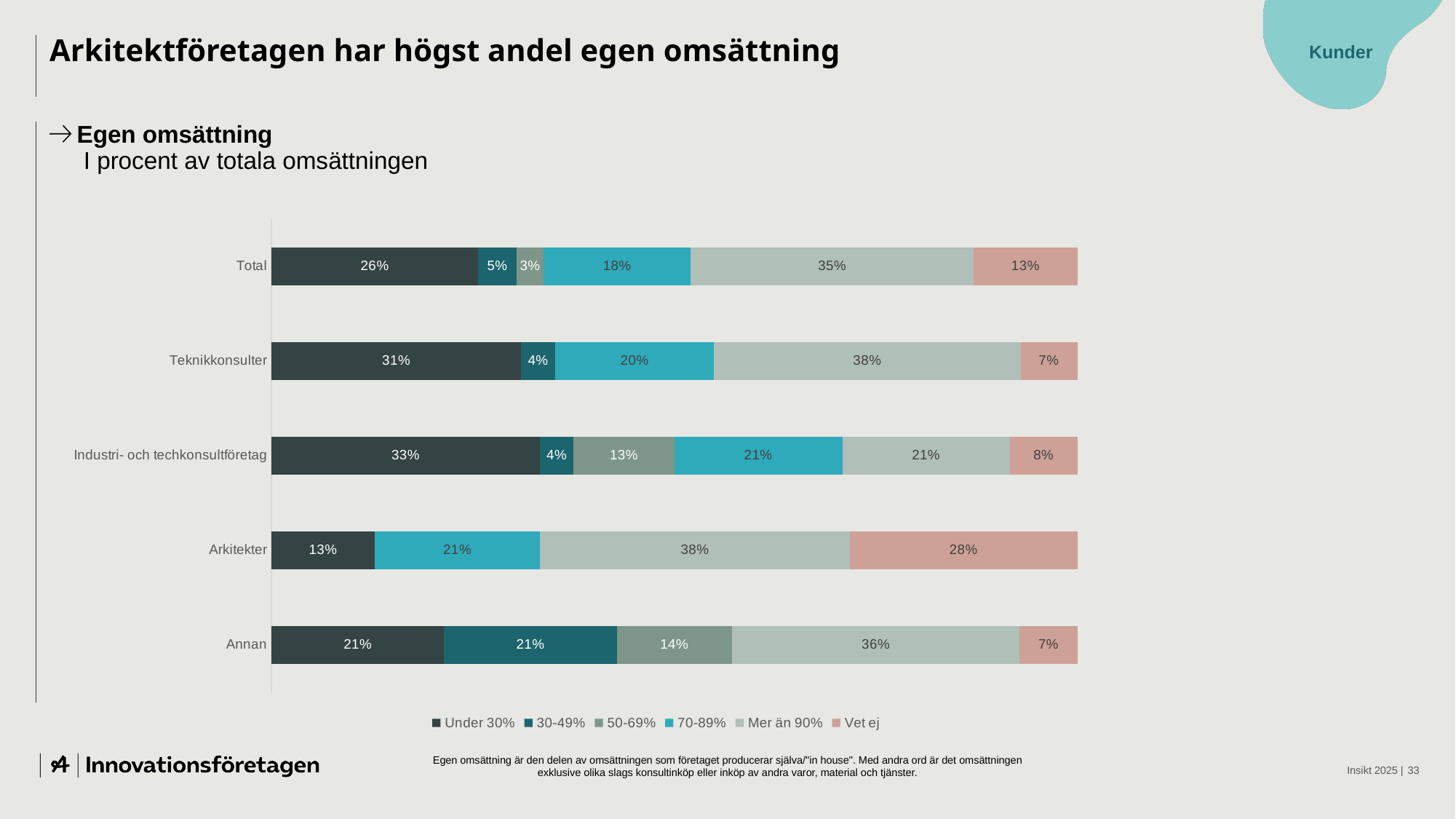
Which is larger: the '70-89%' value for Teknikkonsulter or for Total? Teknikkonsulter What is the 'Under 30%' value for Industri- och techkonsultföretag? 33% What is the 'Mer än 90%' value for Arkitekter? 38% What kind of chart is shown on the slide? Stacked bar chart How many series does the legend list? 6 How many categories are plotted on the chart? 5 What is the subtitle of the chart? Egen omsättning, I procent av totala omsättningen Which category has the highest 'Vet ej' value? Arkitekter What is the '30-49%' value for Annan? 21% What is the difference between the 'Under 30%' values for Teknikkonsulter and Arkitekter? 18% Which category has the lowest 'Under 30%' value? Arkitekter What is the 'Vet ej' value for Total? 13%